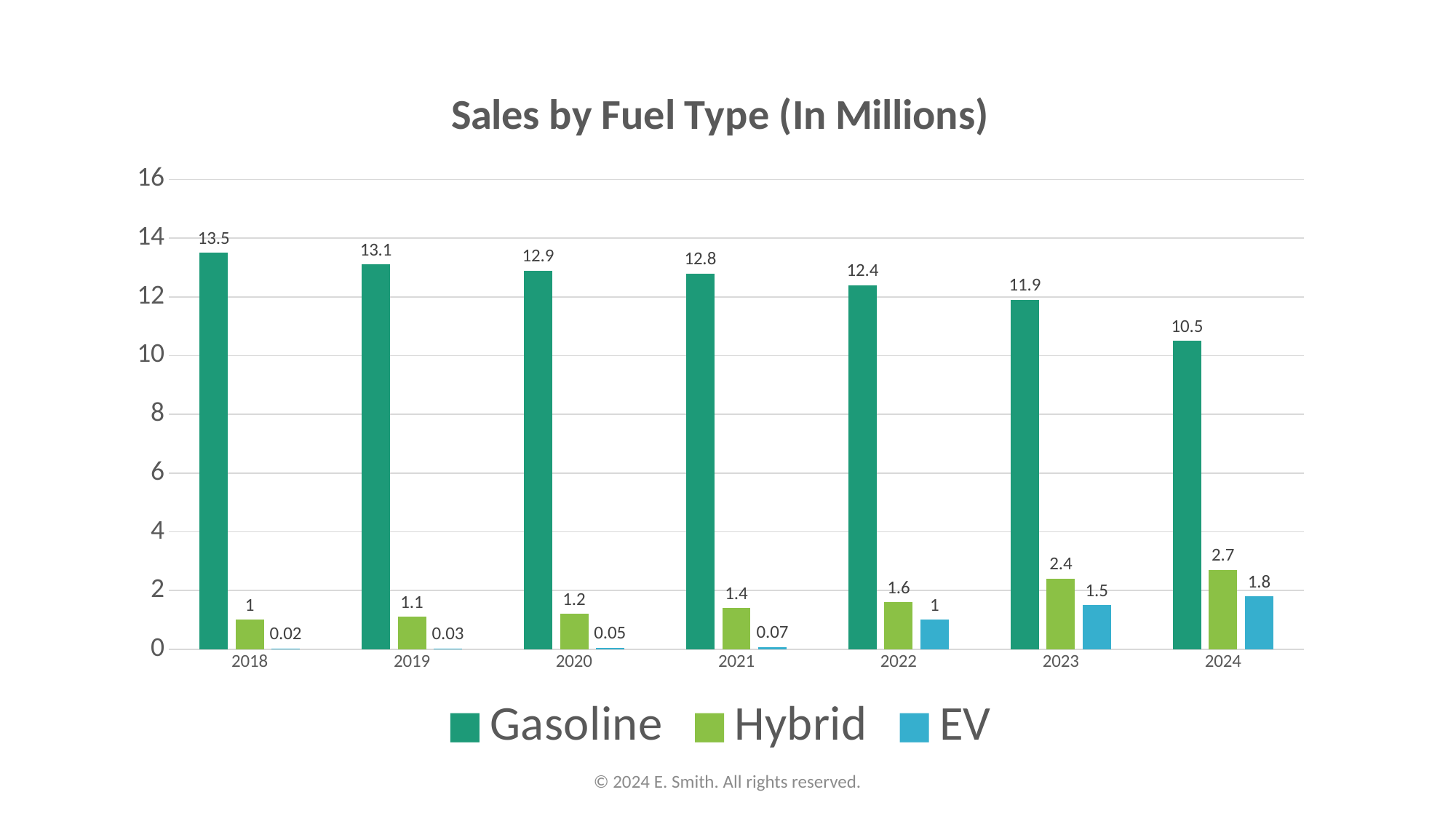
What is the Gasoline value for 2018? 13.5 What is the Hybrid value for 2023? 2.4 Which is larger in 2022, the Hybrid value or the EV value? Hybrid What is the difference between the Hybrid and EV values for 2023? 0.9 Is the Gasoline value for 2023 greater or less than 12? less How many years are shown on the x axis? 7 Do the Gasoline values rise or fall from 2018 to 2024? fall In which year is the EV value highest? 2024 In which year is the Gasoline value lowest? 2024 How many series does the legend list? 3 What is the EV value for 2021? 0.07 What is the difference between the Gasoline values for 2018 and 2024? 3